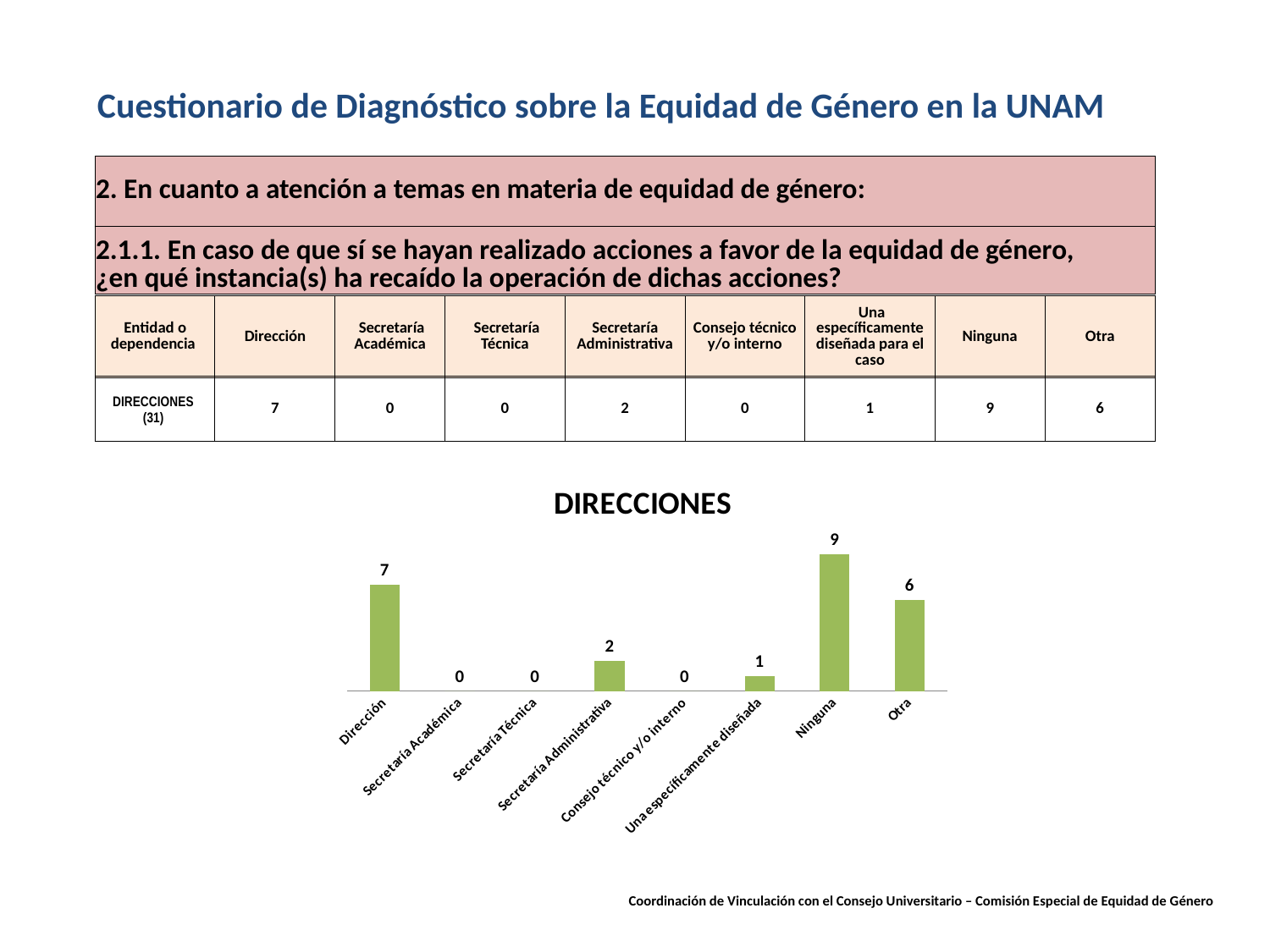
Which is larger in the DIRECCIONES chart, Otra or Secretaría Administrativa? Otra What is the value for Otra in the DIRECCIONES chart? 6 What is the difference between the values for Ninguna and Dirección in the DIRECCIONES chart? 2 What is the title of the chart on the slide? DIRECCIONES What is the value for Secretaría Administrativa in the DIRECCIONES chart? 2 What is the value for Ninguna in the DIRECCIONES chart? 9 How many categories in the DIRECCIONES chart have a value of 0? 3 What kind of chart is the DIRECCIONES chart? Bar chart What is the value for Dirección in the DIRECCIONES chart? 7 Which category has the highest value in the DIRECCIONES chart? Ninguna What is the value for Una específicamente diseñada in the DIRECCIONES chart? 1 How many categories are shown on the x axis of the DIRECCIONES chart? 8